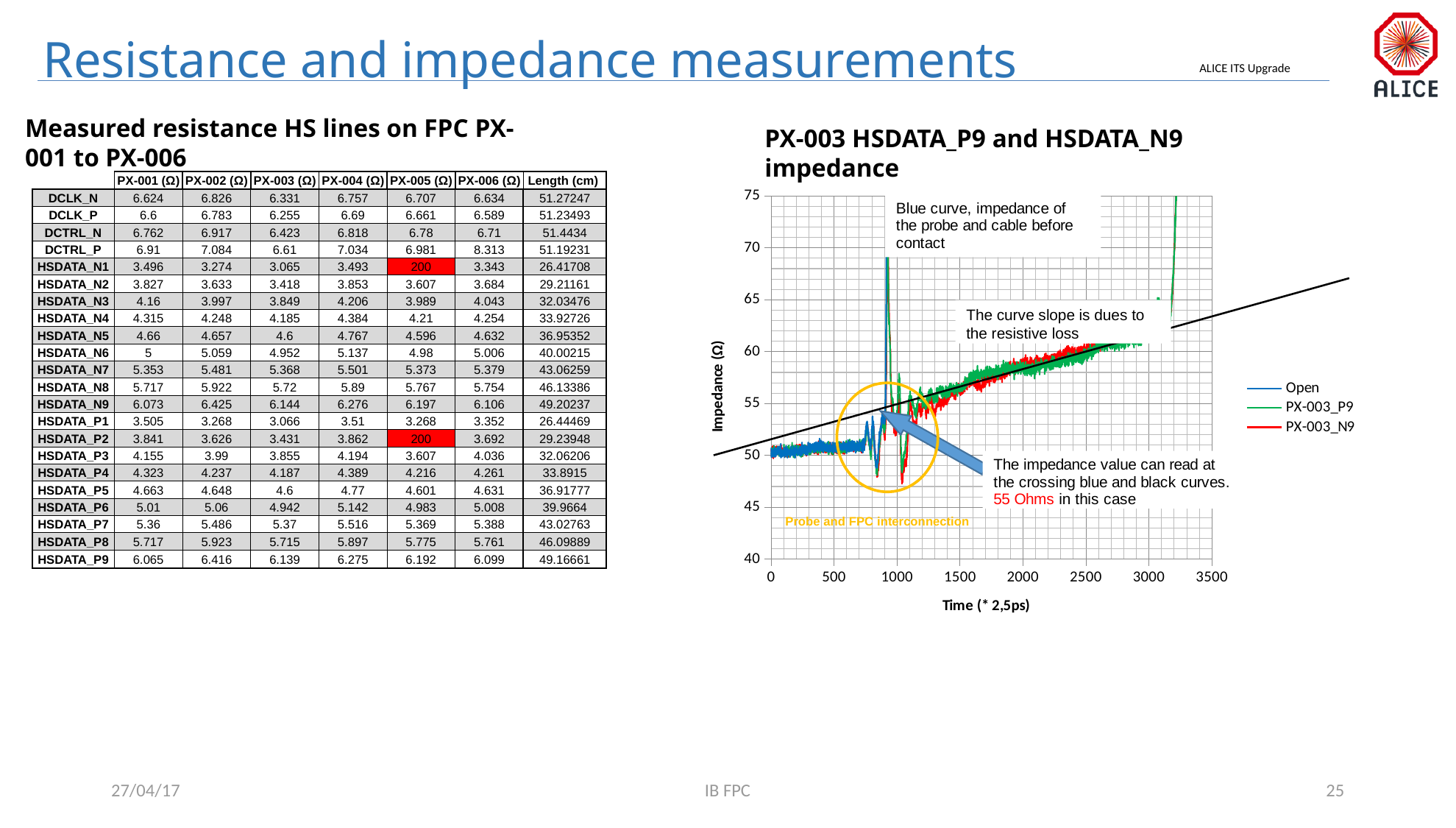
How many series does the legend of the impedance chart list? 3 What is the highest value shown on the y axis of the impedance chart? 75 Which series are listed in the legend of the impedance chart? Open, PX-003_P9, PX-003_N9 On the impedance chart, is the value of PX-003_N9 at time 2000 greater or less than 65? less What is the highest value shown on the x axis of the impedance chart? 3500 What is the label of the y axis of the impedance chart? Impedance (Ω) On the impedance chart, is the value of PX-003_P9 at time 2500 greater or less than 55? greater What is the title of the chart on the right of the slide? PX-003 HSDATA_P9 and HSDATA_N9 impedance What kind of chart is shown on the right of the slide? line chart On the impedance chart, do the PX-003_P9 and PX-003_N9 curves rise or fall along the x axis after the probe and FPC interconnection? rise According to the annotation on the impedance chart, what impedance value is read at the crossing of the blue and black curves? 55 Ohms What is the label of the x axis of the impedance chart? Time (* 2,5ps)